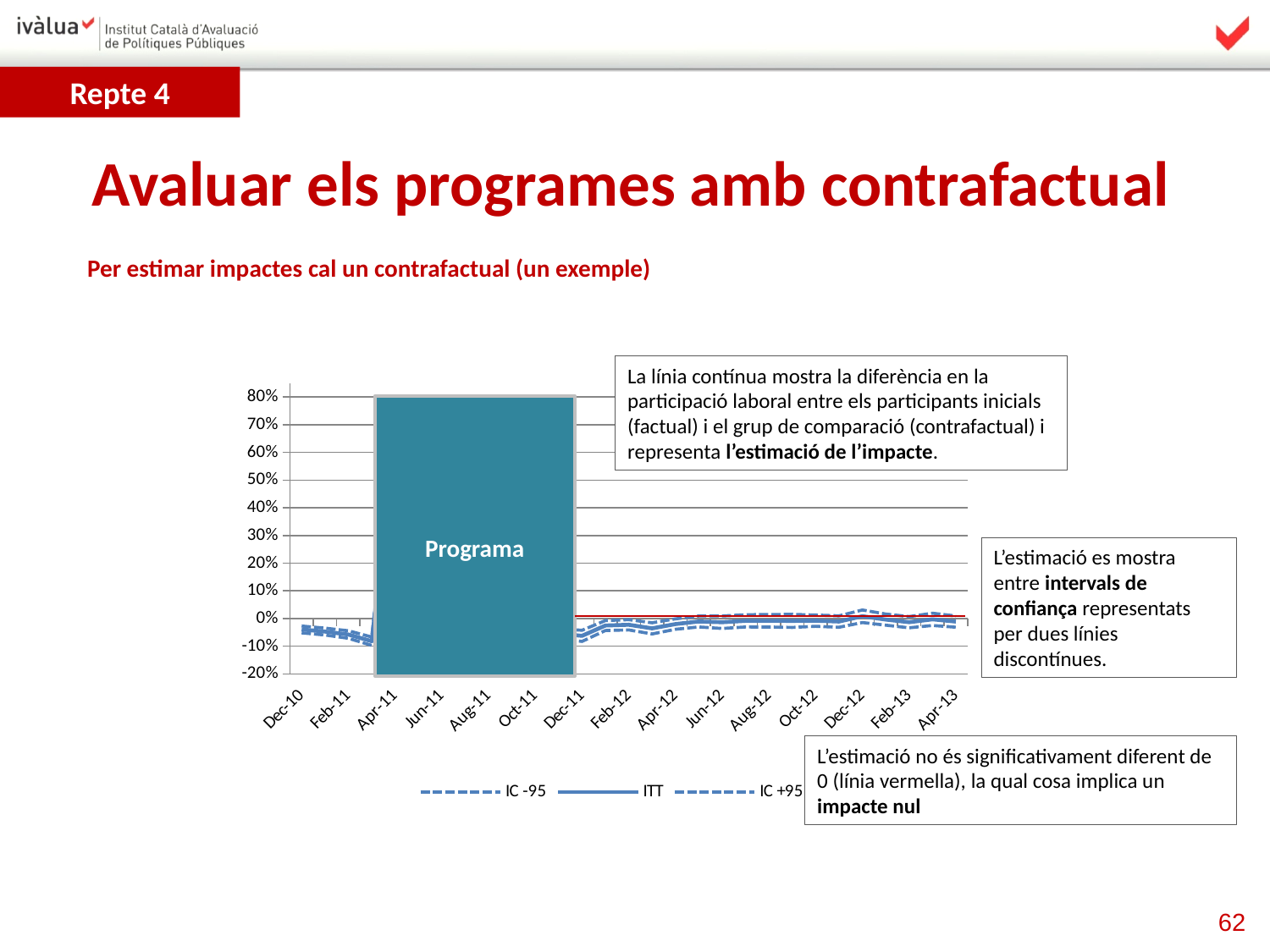
What label appears on the shaded rectangle in the middle of the chart? Programa What is the lowest value shown on the chart's y axis? -20% What is the highest value shown on the chart's y axis? 80% Is the ITT value at Apr-12 greater or less than 10%? less Is the IC +95 value at Dec-12 greater or less than 10%? less How many date labels are shown along the x axis of the chart? 15 How many series does the chart legend list? 3 Is the IC -95 value at Feb-12 greater or less than 0%? less What kind of chart is shown on the slide? line chart What are the three series named in the chart legend? IC -95, ITT, IC +95